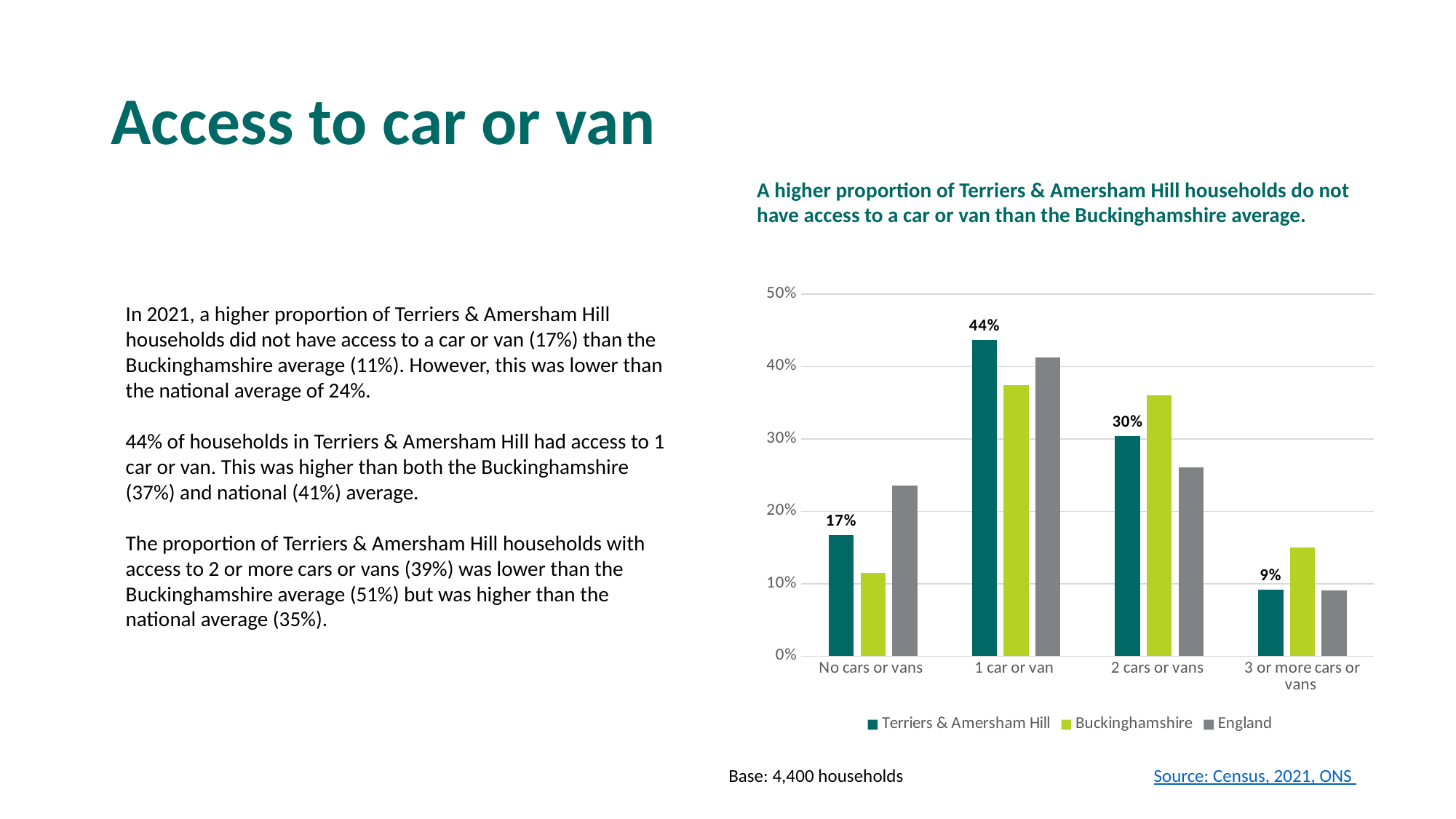
How many categories are shown on the x axis of the chart? 4 What is the value for Terriers & Amersham Hill in the 'No cars or vans' category? 17% In the 'No cars or vans' category, which is larger: Terriers & Amersham Hill or Buckinghamshire? Terriers & Amersham Hill Which category has the lowest value for Terriers & Amersham Hill? 3 or more cars or vans How many series does the chart legend list? 3 What kind of chart is shown on the slide? Bar chart What is the difference between the Terriers & Amersham Hill values for '1 car or van' and '2 cars or vans'? 14% What is the value for Terriers & Amersham Hill in the '3 or more cars or vans' category? 9% What is the value for Terriers & Amersham Hill in the '1 car or van' category? 44% Is the value for Buckinghamshire in the '2 cars or vans' category greater or less than 30%? greater Which category has the highest value for Terriers & Amersham Hill? 1 car or van Is the value for England in the 'No cars or vans' category greater or less than 20%? greater